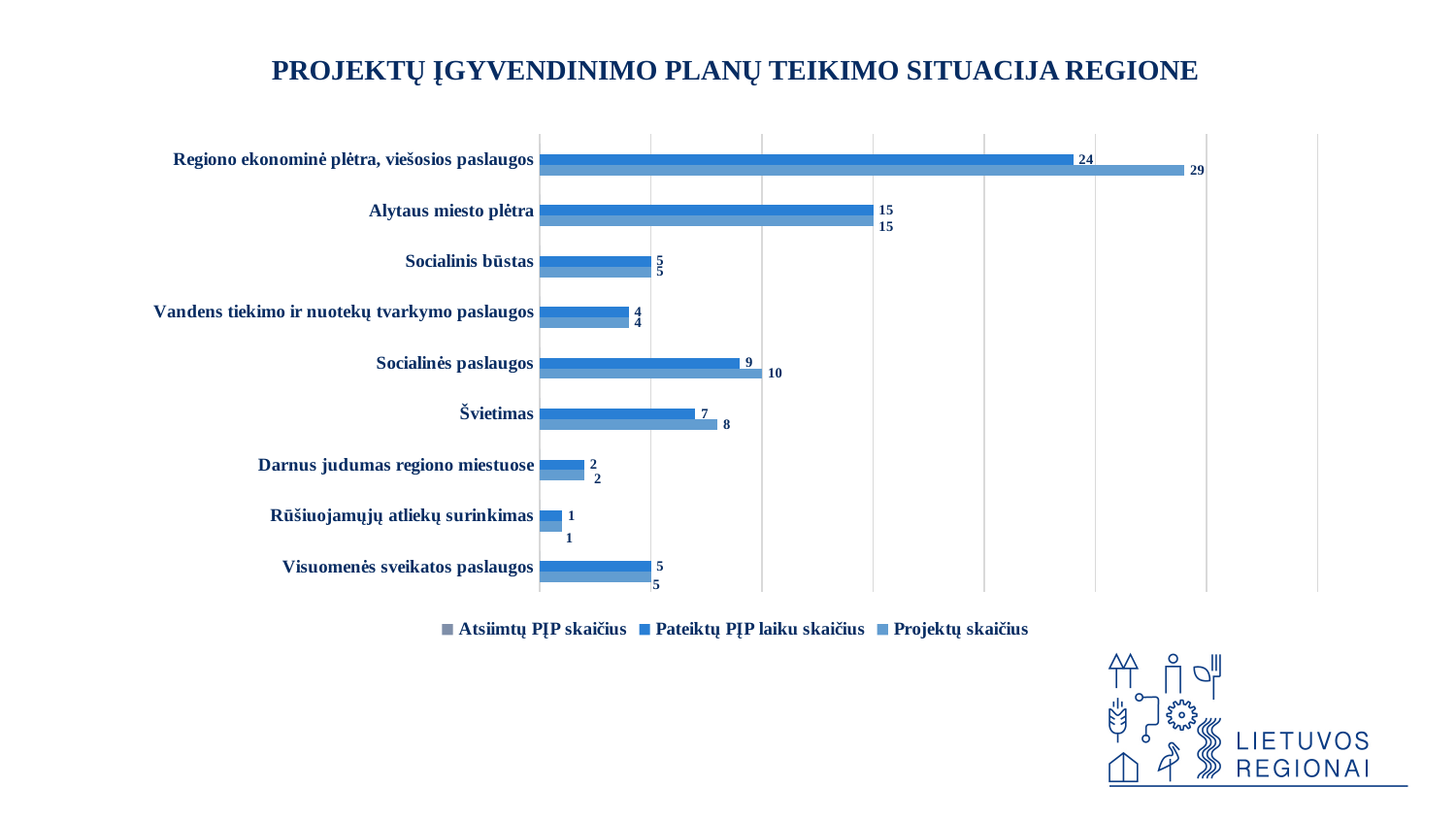
What is the difference between the Projektų skaičius and Pateiktų PĮP laiku skaičius values for Regiono ekonominė plėtra, viešosios paslaugos? 5 What is the Projektų skaičius value for Socialinės paslaugos? 10 What is the Pateiktų PĮP laiku skaičius value for Regiono ekonominė plėtra, viešosios paslaugos? 24 What is the title of the chart? PROJEKTŲ ĮGYVENDINIMO PLANŲ TEIKIMO SITUACIJA REGIONE Which category has the highest Projektų skaičius value? Regiono ekonominė plėtra, viešosios paslaugos What is the Projektų skaičius value for Regiono ekonominė plėtra, viešosios paslaugos? 29 What kind of chart is shown on the slide? bar chart How many categories are shown on the chart? 9 How many series does the legend list? 3 What is the Pateiktų PĮP laiku skaičius value for Švietimas? 7 Which is larger, the Projektų skaičius value for Alytaus miesto plėtra or for Socialinės paslaugos? Alytaus miesto plėtra Which category has the lowest Projektų skaičius value? Rūšiuojamųjų atliekų surinkimas